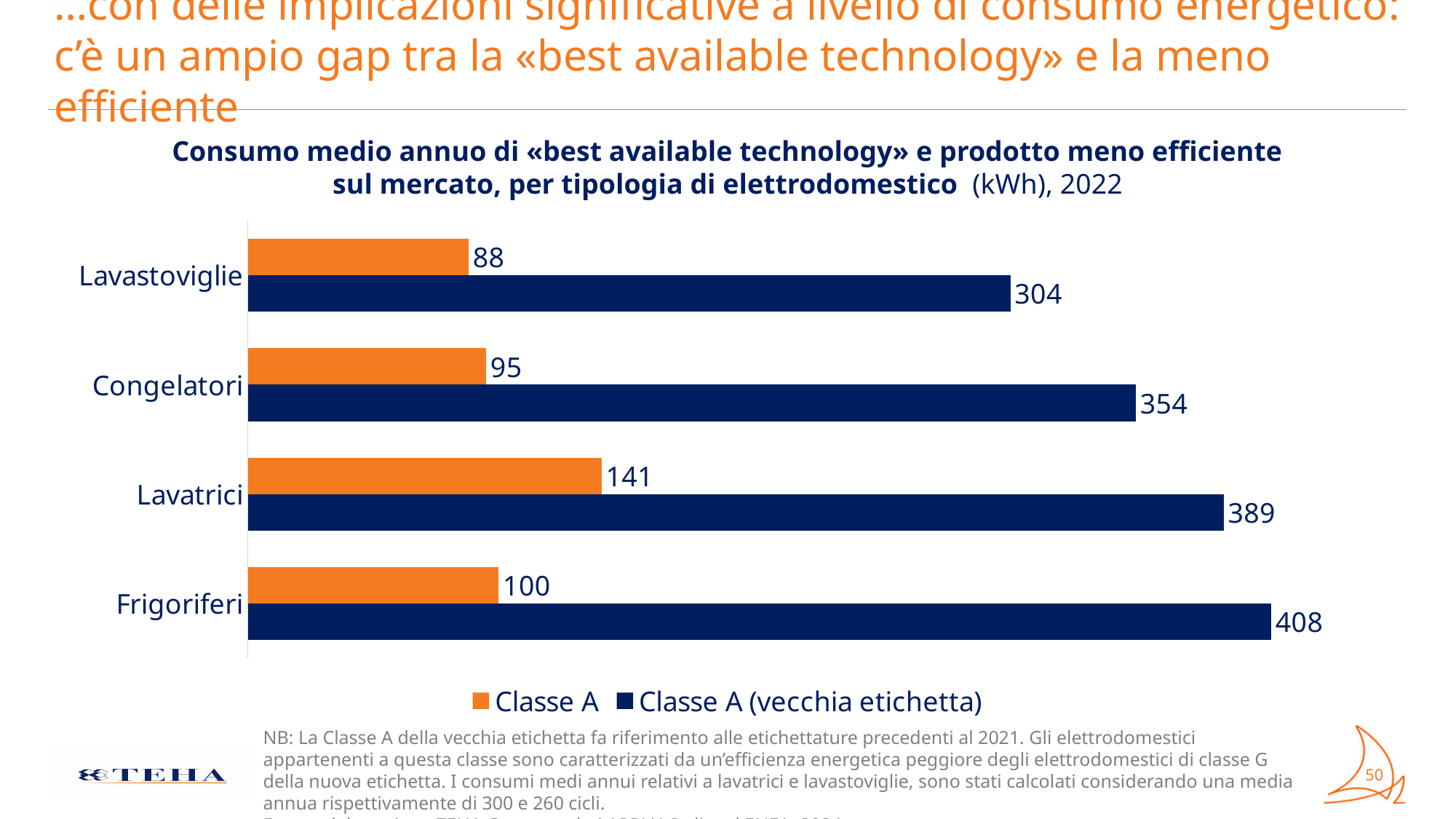
What kind of chart is shown on the slide? Bar chart What is the Classe A value for Lavatrici? 141 Which category has the highest Classe A (vecchia etichetta) value? Frigoriferi What is the Classe A value for Lavastoviglie? 88 How many series does the legend list? 2 Which is larger, the Classe A value for Congelatori or for Frigoriferi? Frigoriferi Which category has the lowest Classe A value? Lavastoviglie How many appliance categories are shown in the chart? 4 What is the difference between the Classe A (vecchia etichetta) and Classe A values for Frigoriferi? 308 What is the Classe A (vecchia etichetta) value for Frigoriferi? 408 What is the Classe A (vecchia etichetta) value for Congelatori? 354 What is the difference between the Classe A (vecchia etichetta) values for Lavatrici and Lavastoviglie? 85